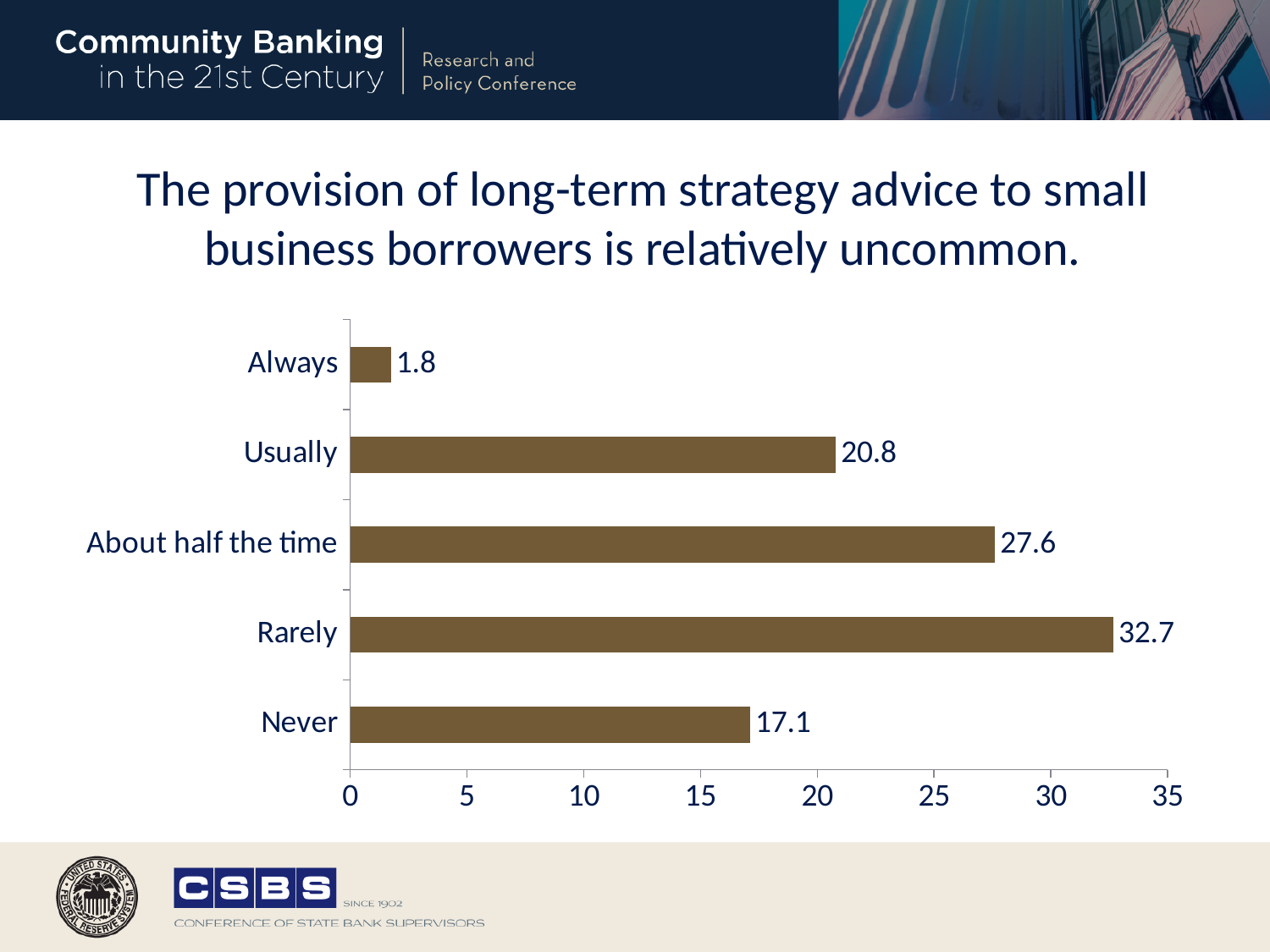
What is the value for "About half the time"? 27.6 What is the difference between the values for "About half the time" and "Usually"? 6.8 What is the value for "Never"? 17.1 How many categories are shown in the chart? 5 What kind of chart is shown on the slide? bar chart What is the difference between the values for "Rarely" and "Never"? 15.6 What is the value for "Rarely"? 32.7 Which is larger, the value for "Usually" or the value for "Never"? Usually Which category has the highest value? Rarely What is the value for "Always"? 1.8 Which category has the lowest value? Always Is the value for "Usually" greater or less than 25? less